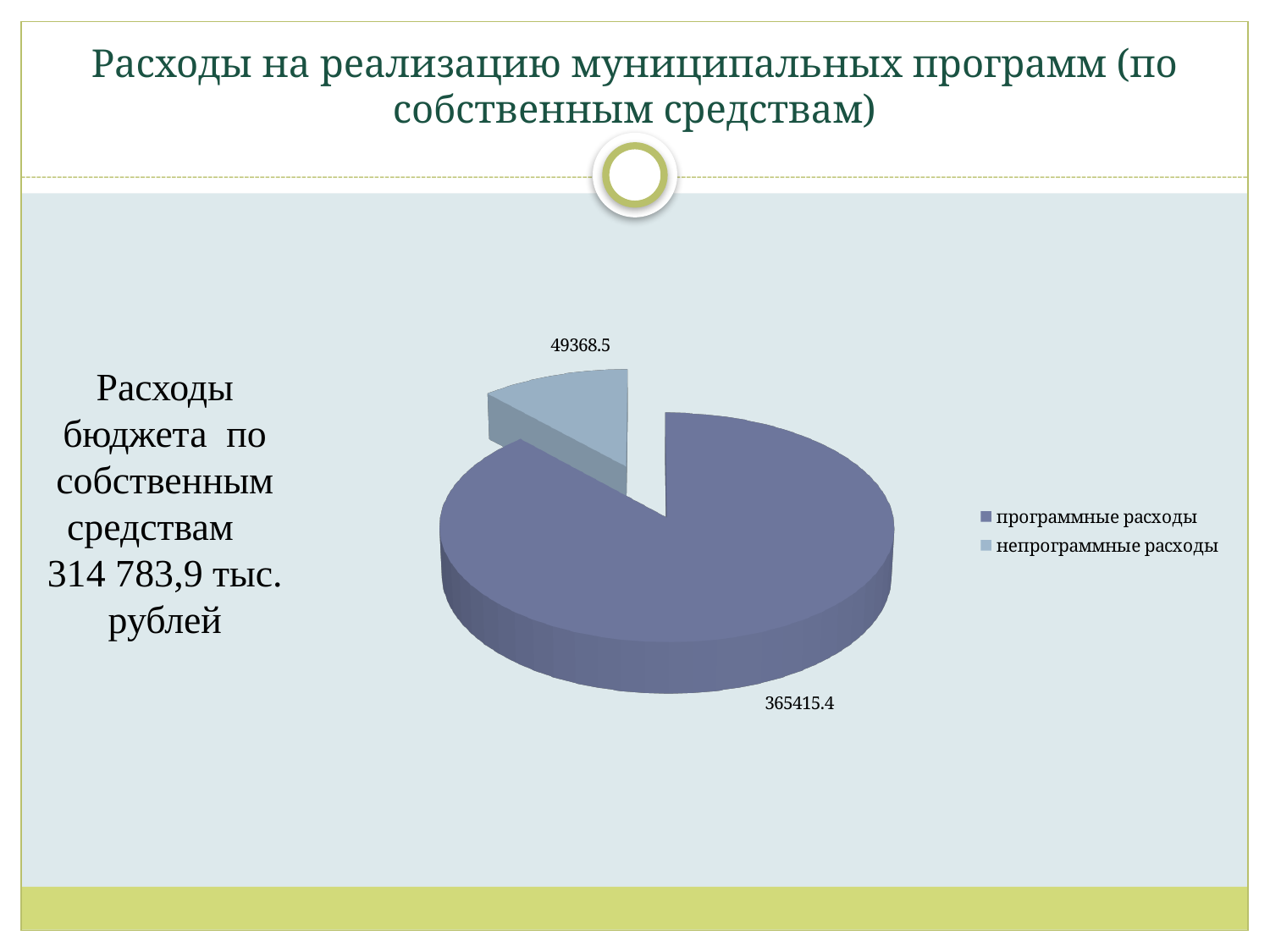
How many entries does the legend list? 2 How many slices does the pie chart have? 2 What is the title of the slide containing the chart? Расходы на реализацию муниципальных программ (по собственным средствам) What is the total of the two slices in the pie chart? 414783.9 What is the difference between программные расходы and непрограммные расходы? 316046.9 What is the value for программные расходы? 365415.4 What type of chart is shown on the slide? pie chart Which is larger, программные расходы or непрограммные расходы? программные расходы Which category has the smallest slice of the pie? непрограммные расходы What is the value for непрограммные расходы? 49368.5 Which category has the largest slice of the pie? программные расходы Which legend entry is shown in the lighter blue colour? непрограммные расходы